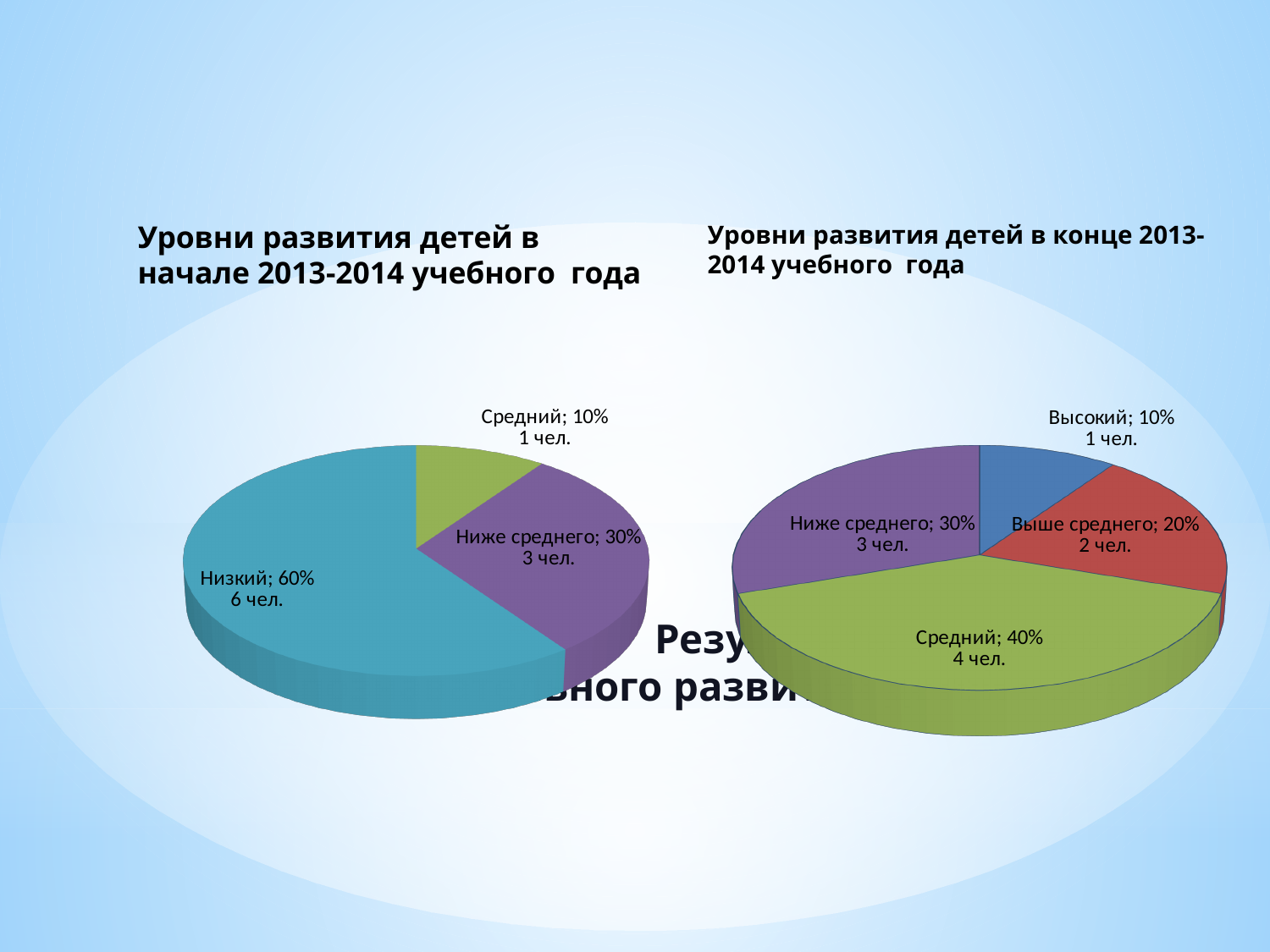
In the left pie chart (start of the 2013-2014 school year), which category has the smallest share? Средний Which is larger: the 'Средний' share in the left pie chart or the 'Средний' share in the right pie chart? The right pie chart In the left pie chart (start of the 2013-2014 school year), which category has the largest share? Низкий In the left pie chart (start of the 2013-2014 school year), how many children are in the 'Ниже среднего' category? 3 чел. How many slices does the right pie chart (end of the 2013-2014 school year) have? 4 In the right pie chart (end of the 2013-2014 school year), how many children are in the 'Выше среднего' category? 2 чел. In the right pie chart (end of the 2013-2014 school year), what percentage is the 'Средний' slice? 40% What kind of charts are shown on the slide? Pie charts In the right pie chart (end of the 2013-2014 school year), which category has the largest share? Средний In the right pie chart (end of the 2013-2014 school year), what is the difference in percentage points between 'Средний' and 'Высокий'? 30 How many slices does the left pie chart (start of the 2013-2014 school year) have? 3 In the left pie chart (start of the 2013-2014 school year), what percentage is the 'Низкий' slice? 60%